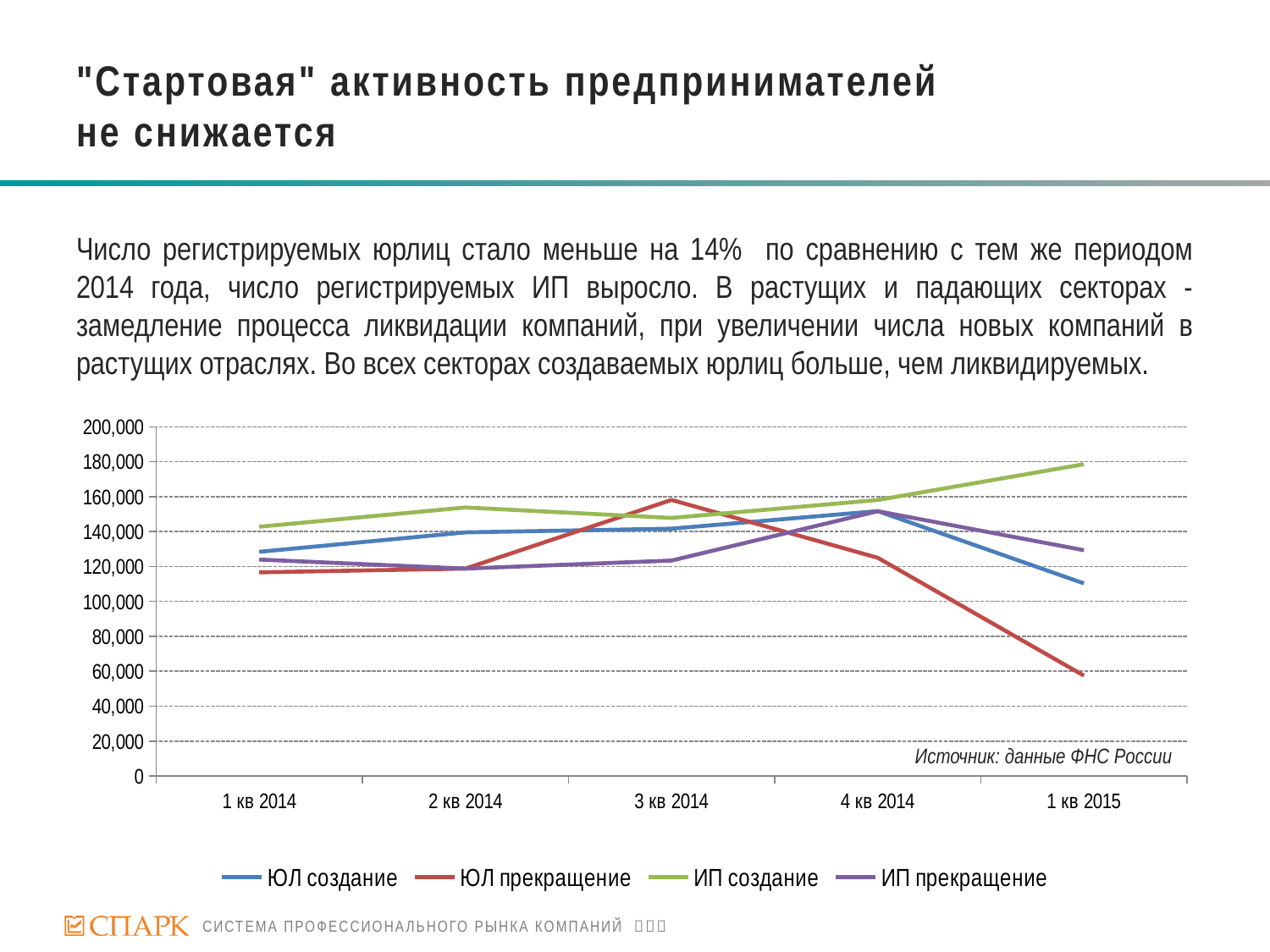
What source is cited on the chart? данные ФНС России Does ИП создание rise or fall from 4 кв 2014 to 1 кв 2015? rise Is the value for ЮЛ прекращение in 1 кв 2015 greater or less than 80,000? less Which series has the lowest value in 1 кв 2015? ЮЛ прекращение In 3 кв 2014, which is larger: ЮЛ прекращение or ЮЛ создание? ЮЛ прекращение Is the value for ИП создание in 1 кв 2015 greater or less than 160,000? greater How many series does the legend list? 4 In which quarter does ЮЛ прекращение reach its highest value? 3 кв 2014 Is the value for ЮЛ создание in 1 кв 2014 greater or less than 120,000? greater What type of chart is shown on the slide? line chart Which series has the highest value in 1 кв 2015? ИП создание How many quarters are shown on the x axis? 5